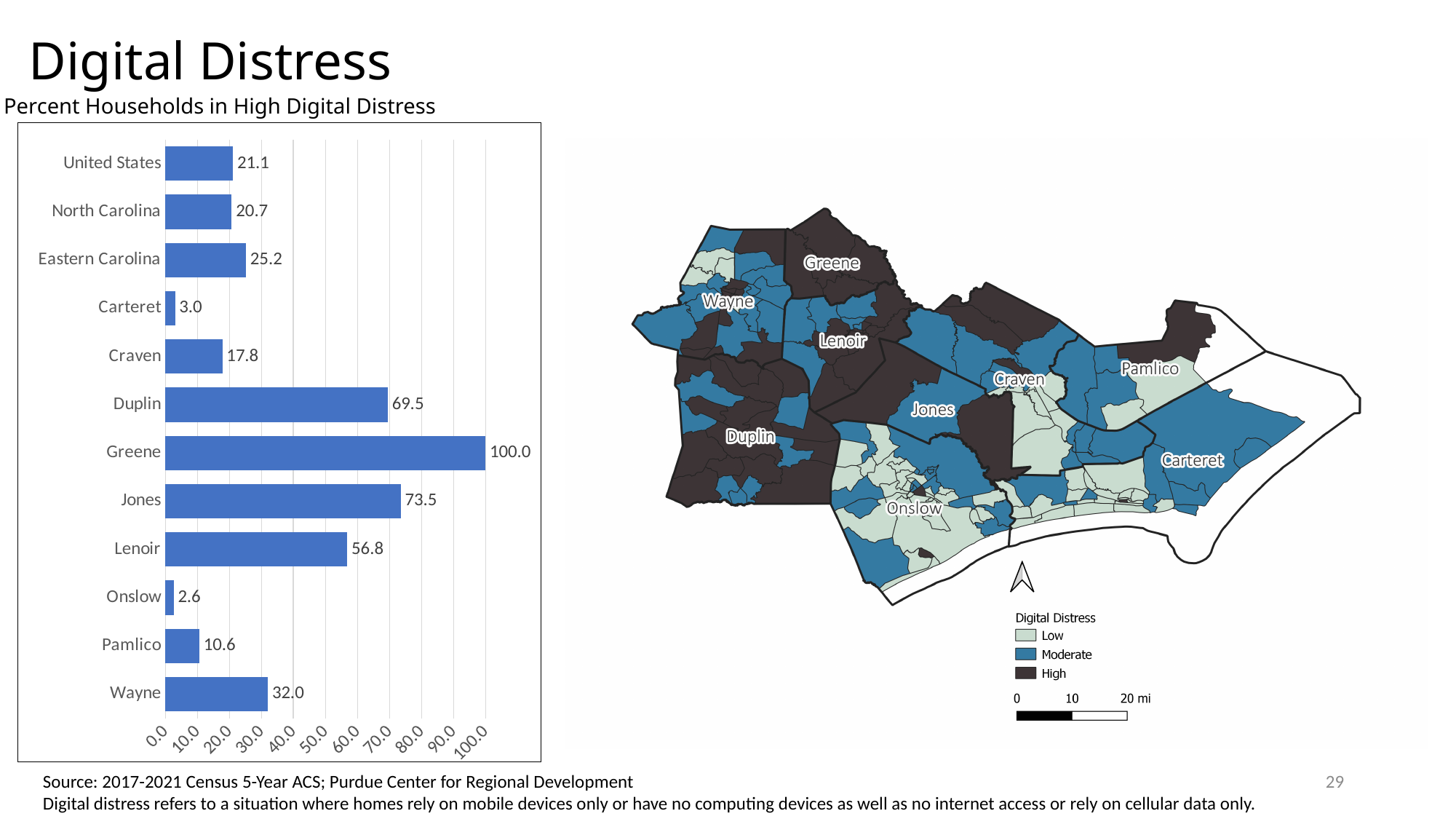
Which category has the highest value in the bar chart? Greene What kind of chart is shown on the left of the slide? Bar chart What is the value for Greene in the Percent Households in High Digital Distress chart? 100.0 How many categories are shown in the bar chart? 12 What is the value for North Carolina in the bar chart? 20.7 What is the difference between the values for Eastern Carolina and the United States in the bar chart? 4.1 Which has a larger value in the bar chart, Duplin or Wayne? Duplin Which category has the lowest value in the bar chart? Onslow Is the value for Lenoir in the bar chart greater or less than 50.0? greater What is the value for Onslow in the bar chart? 2.6 What is the difference between the values for Jones and Lenoir in the bar chart? 16.7 How many categories does the map legend for Digital Distress list? 3